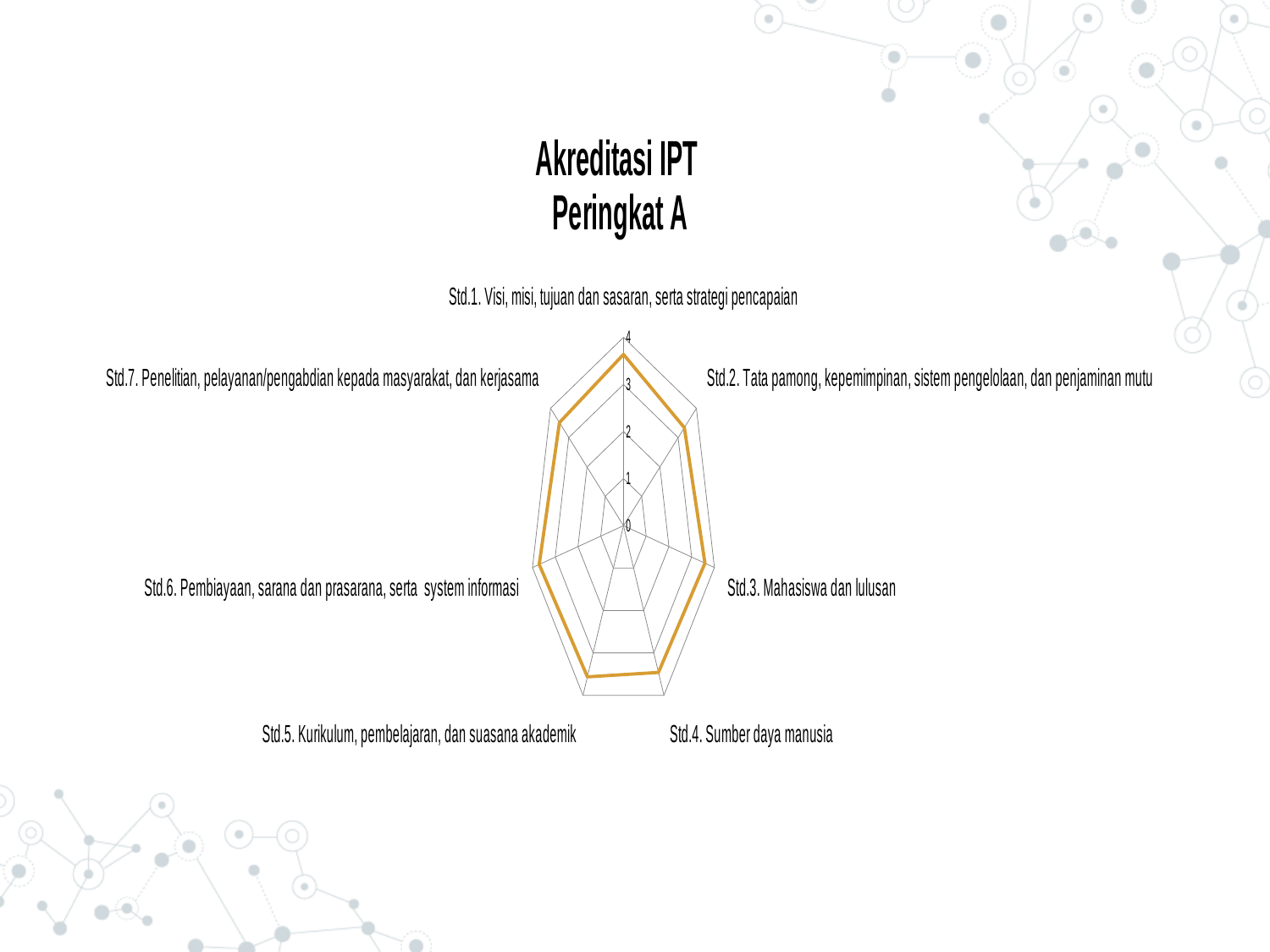
How many categories (axes) does the radar chart have? 7 How many data series are plotted on the radar chart? 1 Is the value for Std.7. Penelitian, pelayanan/pengabdian kepada masyarakat, dan kerjasama greater or less than 2? greater What kind of chart is shown on the slide? radar chart What is the title of the chart? Akreditasi IPT Peringkat A Is the value for Std.4. Sumber daya manusia greater or less than 4? less Is the value for Std.1. Visi, misi, tujuan dan sasaran, serta strategi pencapaian greater or less than 3? greater What is the highest tick value shown on the chart's axis scale? 4